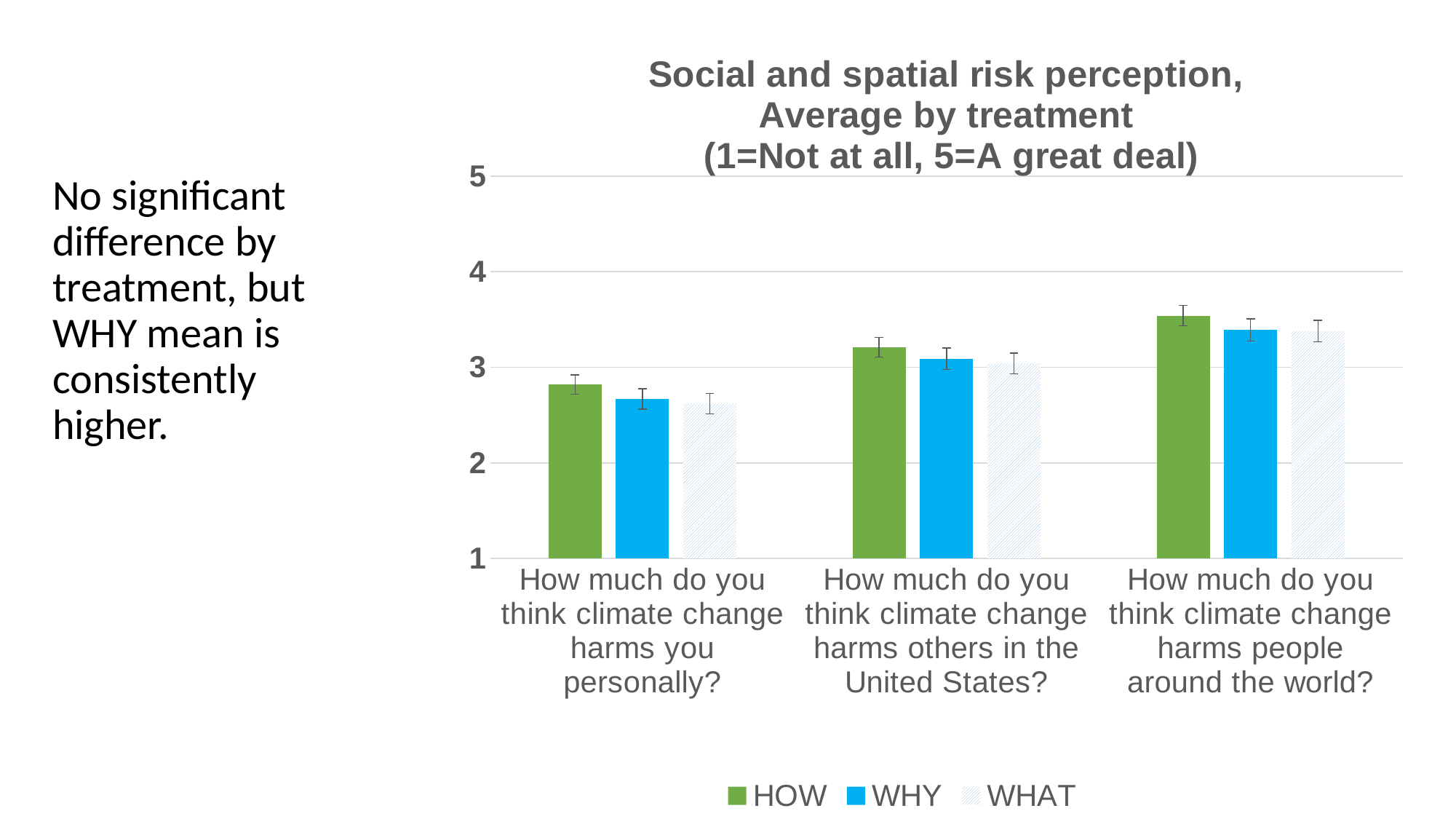
For which question category is the HOW bar highest? How much do you think climate change harms people around the world? Is the WHAT value for "How much do you think climate change harms you personally?" greater or less than 3? less Is the HOW value for "How much do you think climate change harms you personally?" greater or less than 3? less How many question categories are shown on the x axis? 3 Is the HOW value for "How much do you think climate change harms people around the world?" greater or less than 3? greater What kind of chart is shown on the slide? bar chart Which series is shown in green in the legend? HOW For which question category is the WHY bar lowest? How much do you think climate change harms you personally? Do the HOW values rise or fall moving from the "harms you personally" category to the "harms people around the world" category? rise What is the scale range described in the chart title? 1=Not at all, 5=A great deal How many series does the legend list? 3